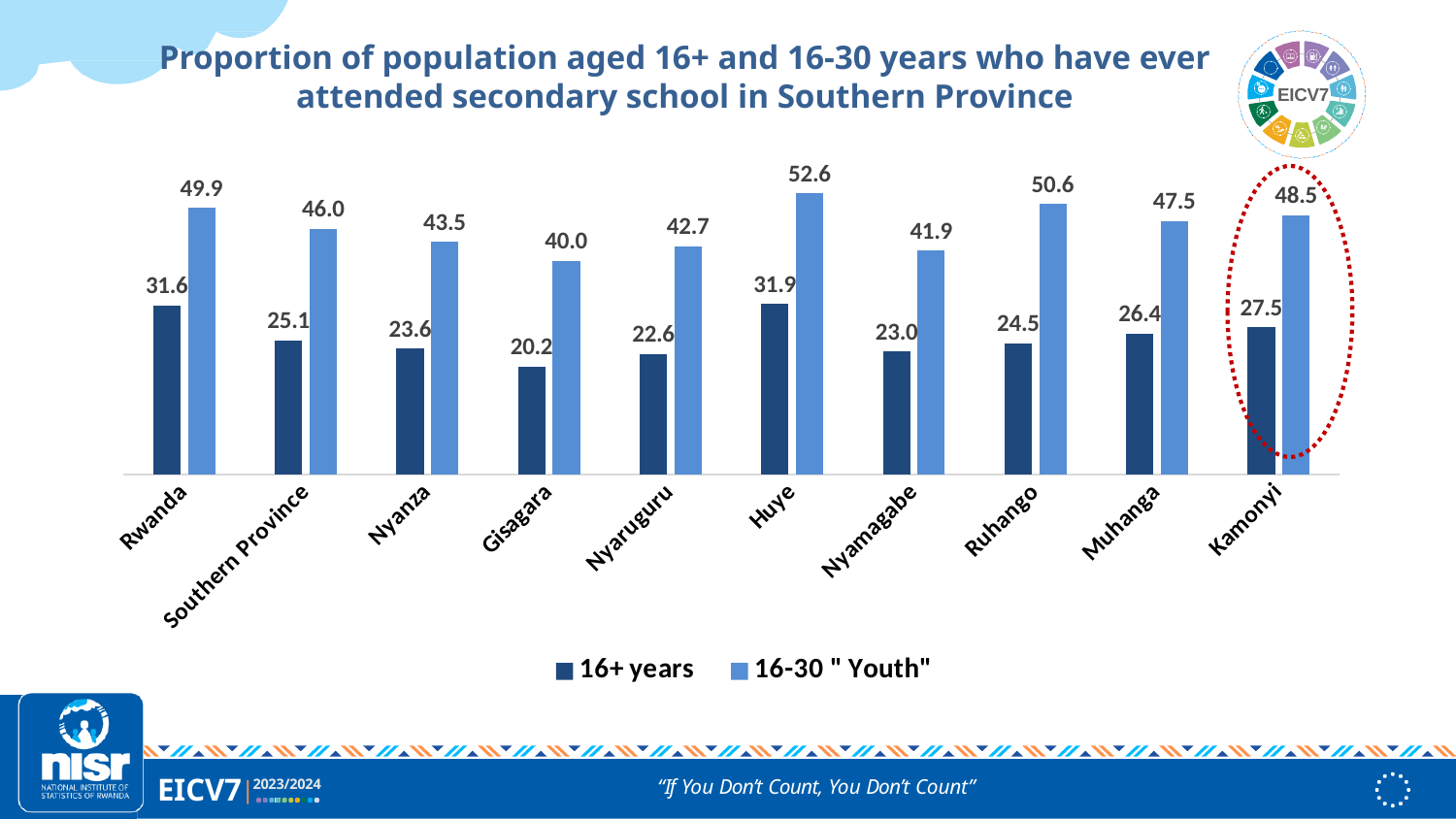
What kind of chart is shown on the slide? Bar chart Which has the larger 16-30 "Youth" value, Ruhango or Muhanga? Ruhango Which category has the highest value for the 16-30 "Youth" series? Huye What is the difference between the 16-30 "Youth" value and the 16+ years value for Kamonyi? 21.0 What is the value for the 16+ years series for Kamonyi? 27.5 What is the value for the 16+ years series for Southern Province? 25.1 What is the value for the 16-30 "Youth" series for Gisagara? 40.0 How many categories are shown on the x axis? 10 Which category has the lowest value for the 16+ years series? Gisagara How many series does the legend list? 2 Which category is highlighted with a red dotted circle? Kamonyi What is the value for the 16-30 "Youth" series for Huye? 52.6